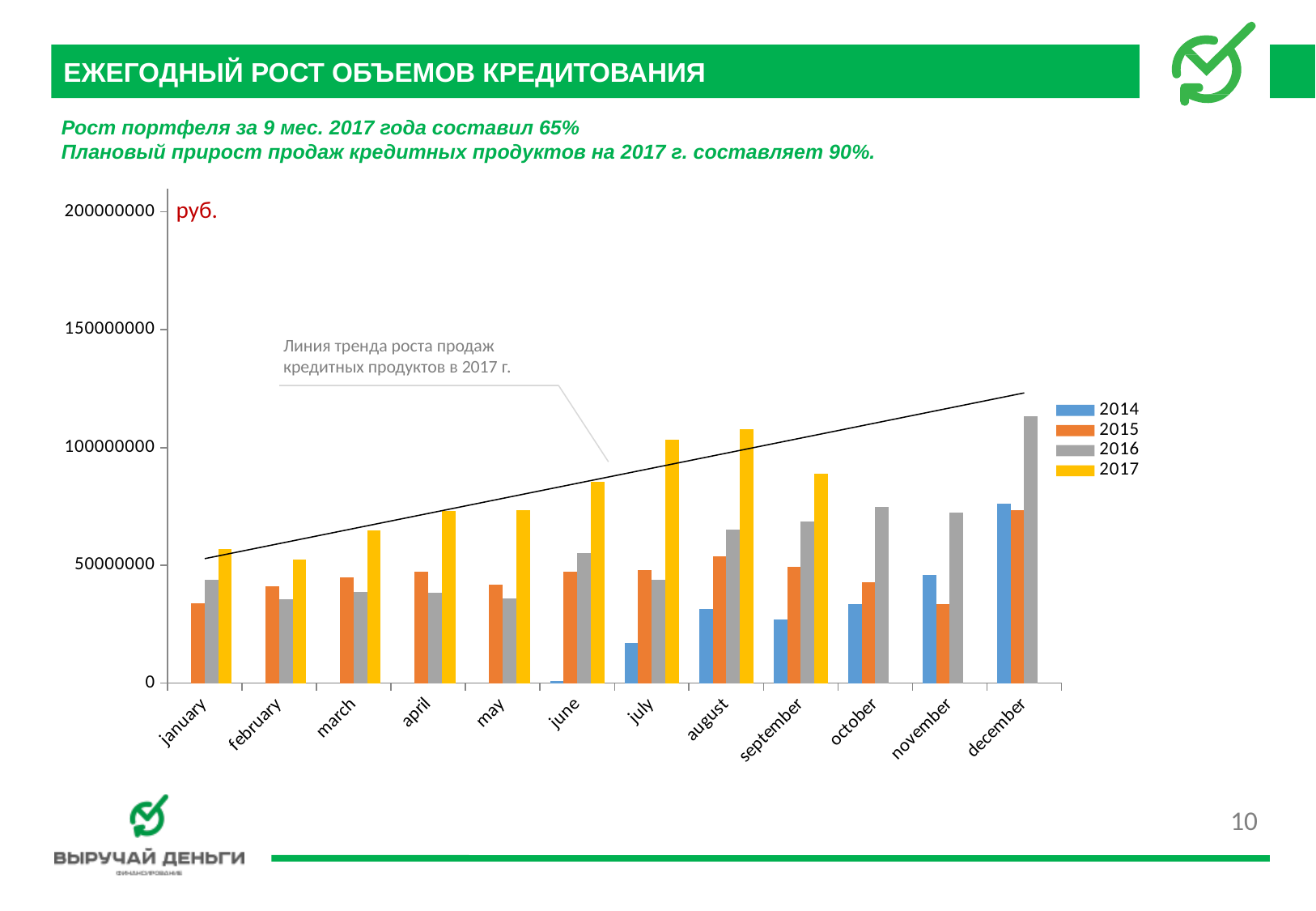
How many months are shown on the x axis? 12 What kind of chart is shown on the slide? bar chart In august, which is larger: the 2017 value or the 2016 value? 2017 Which month has the highest 2016 value? december Is the 2017 value for august greater or less than 100000000? greater Which month has the lowest 2017 value? february Is the 2015 value for january greater or less than 50000000? less Which month has the highest 2017 value? august For how many months is a 2017 bar plotted? 9 Does the trend line drawn on the chart rise or fall from left to right? rise How many series does the legend list? 4 Is the 2016 value for december greater or less than 100000000? greater